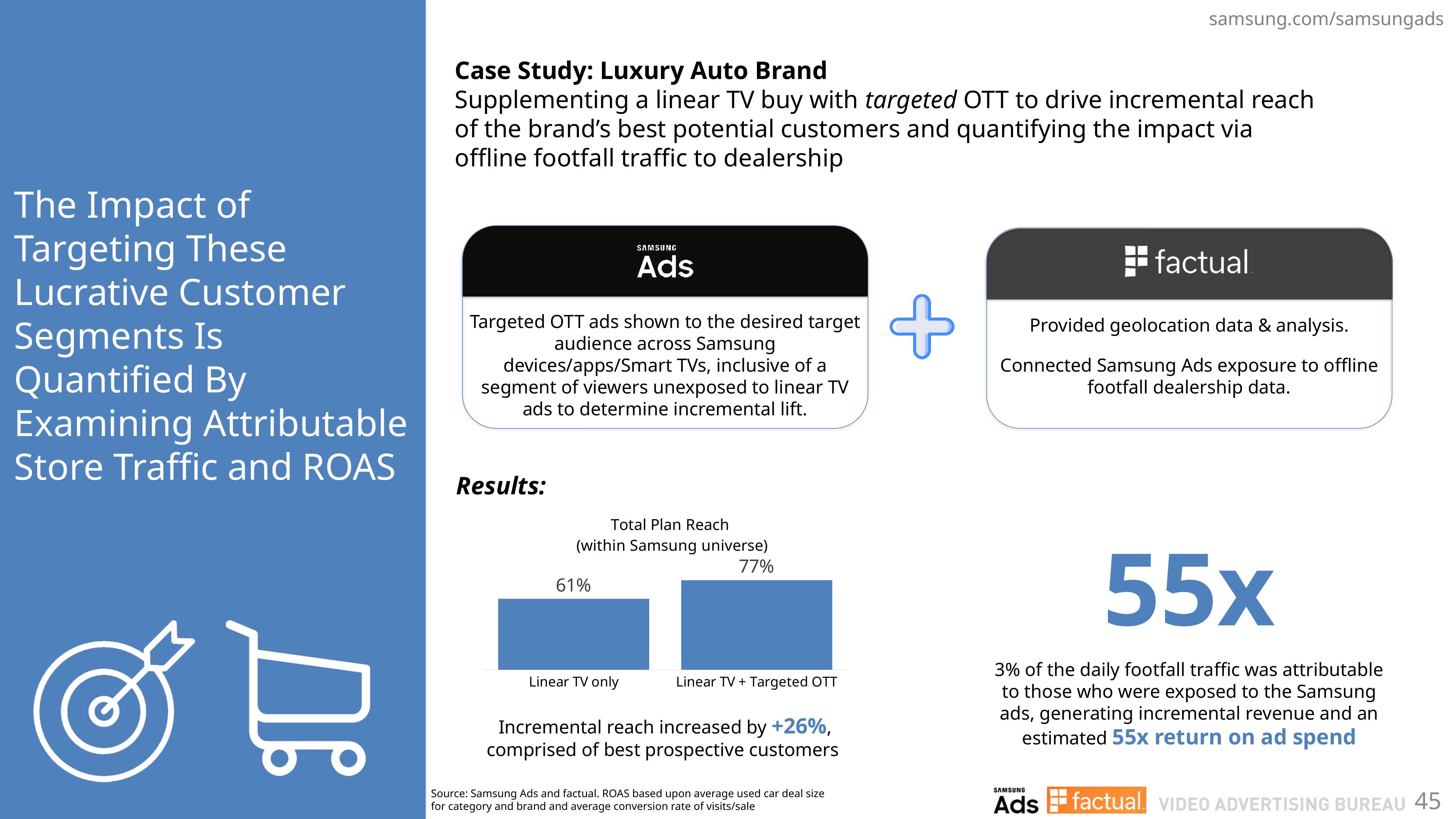
Do the values in the Total Plan Reach chart rise or fall from left to right? rise Is the Total Plan Reach for Linear TV only larger or smaller than for Linear TV + Targeted OTT? smaller What colour are the bars in the Total Plan Reach chart? blue What kind of chart is the Total Plan Reach chart? bar chart How many categories are shown in the Total Plan Reach chart? 2 What is the title of the chart on the slide? Total Plan Reach (within Samsung universe) What is the Total Plan Reach value for Linear TV only? 61% Which category has the higher Total Plan Reach? Linear TV + Targeted OTT Which category has the lower Total Plan Reach? Linear TV only What is the Total Plan Reach value for Linear TV + Targeted OTT? 77% What is the difference in Total Plan Reach between Linear TV + Targeted OTT and Linear TV only? 16%